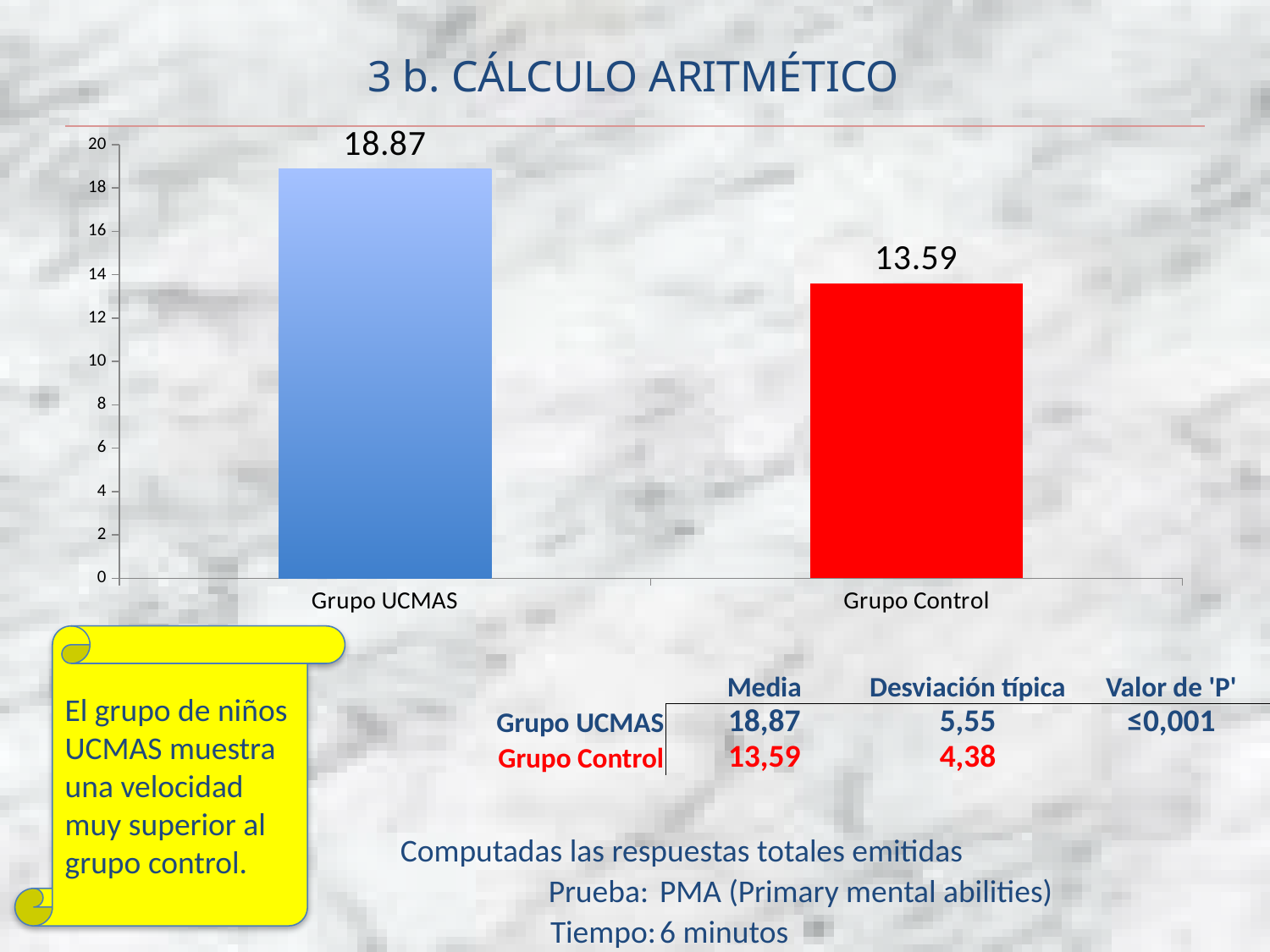
What is the value for Grupo Control? 13.59 What kind of chart is shown on the slide? bar chart Which group has the lowest value? Grupo Control What is the difference between the values for Grupo UCMAS and Grupo Control? 5.28 What is the value for Grupo UCMAS? 18.87 What is the title of the slide containing the chart? 3 b. CÁLCULO ARITMÉTICO Which group has the highest value? Grupo UCMAS Which is larger, the value for Grupo UCMAS or the value for Grupo Control? Grupo UCMAS What colour is the bar for Grupo Control? red How many categories are shown on the chart? 2 Is the value for Grupo UCMAS greater or less than 18? greater Is the value for Grupo Control greater or less than 14? less